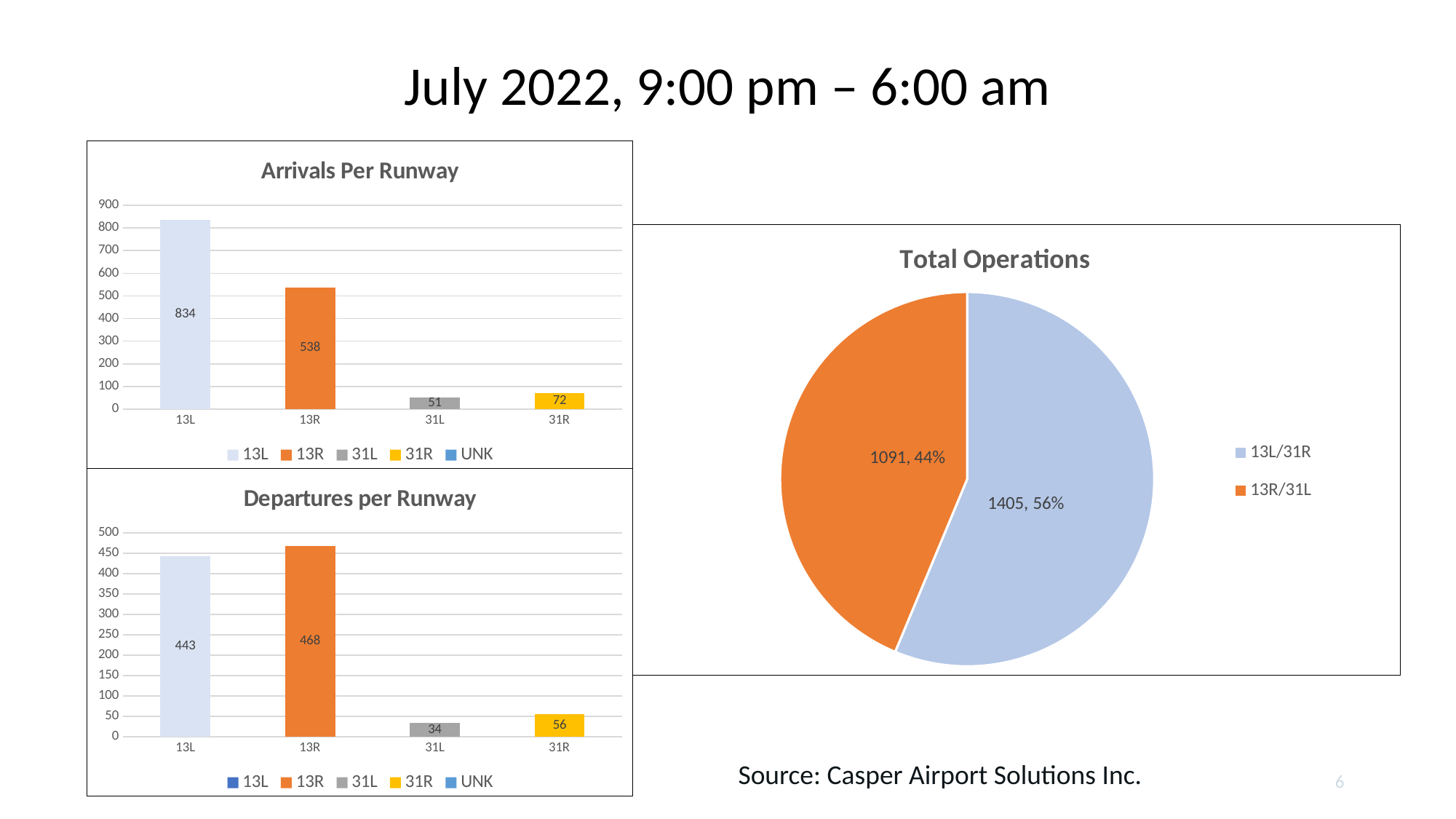
In the Total Operations chart, what share of operations is 13R/31L? 44% In the Arrivals Per Runway chart, which runway has the lowest number of arrivals? 31L In the Arrivals Per Runway chart, what is the difference between arrivals on 13L and 13R? 296 How many runway categories are shown on the x axis of the Arrivals Per Runway chart? 4 In the Total Operations chart, what is the value for 13L/31R? 1405 In the Departures per Runway chart, which is larger: departures on 31L or 31R? 31R How many entries does the legend of the Departures per Runway chart list? 5 In the Departures per Runway chart, what is the difference between departures on 31R and 31L? 22 In the Arrivals Per Runway chart, what is the value for runway 13L? 834 In the Departures per Runway chart, which runway has the highest number of departures? 13R What kind of chart is the Total Operations chart? pie chart In the Departures per Runway chart, what is the value for runway 13R? 468